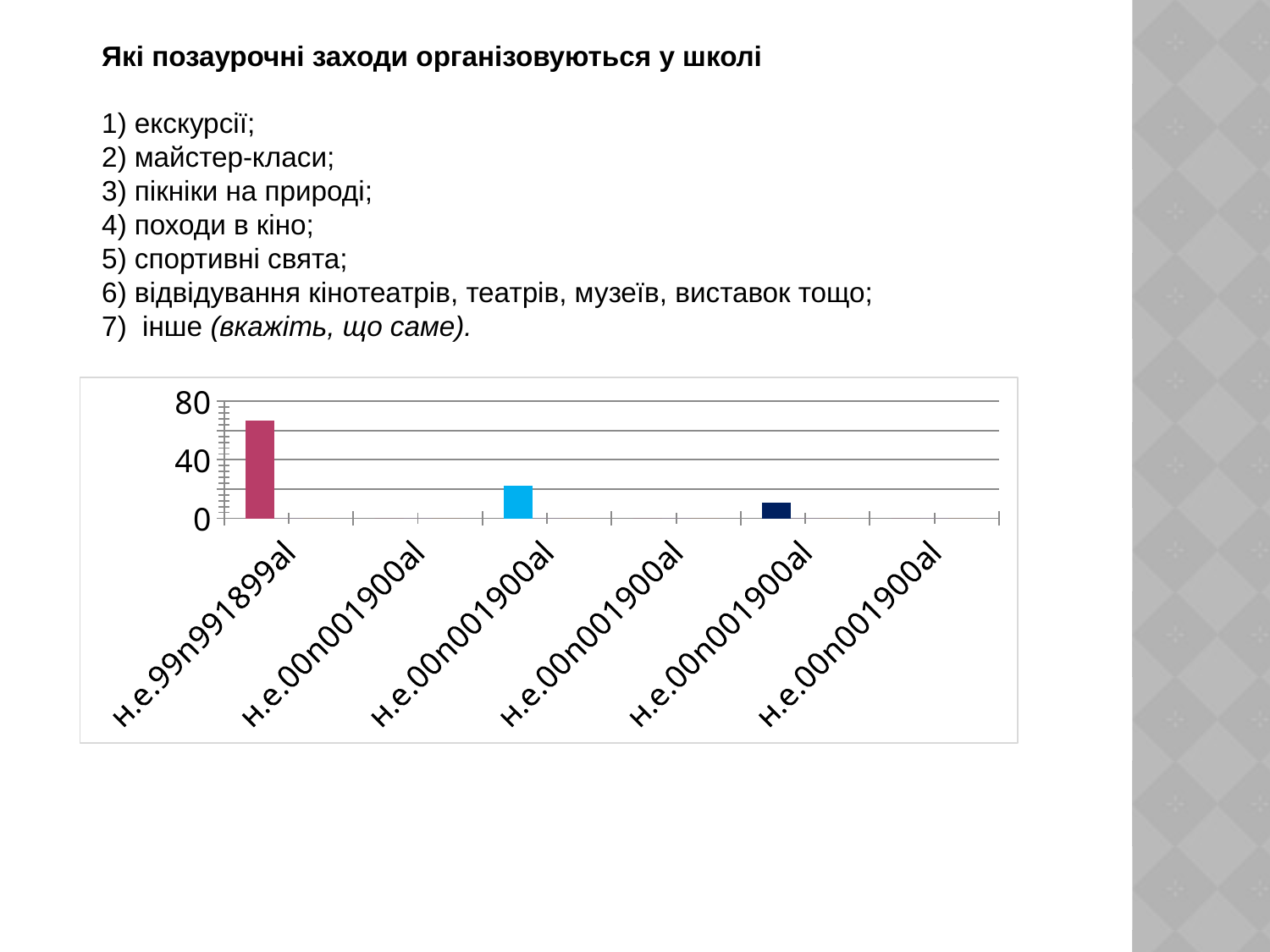
Do the bar values rise or fall from left to right across the chart? fall Which bar in the chart is the shortest? the dark blue bar on the right What colour is the tallest bar in the chart? pink Is the value of the dark blue bar greater or less than 40? less What kind of chart is shown on the slide? bar chart How many bars are plotted in the chart? 3 Is the value of the first (pink) bar greater or less than 40? greater Which bar in the chart is the tallest? the first (pink) bar on the left What is the highest value shown on the vertical axis of the chart? 80 Is the value of the light blue bar greater or less than 40? less Which is larger, the light blue bar or the dark blue bar? the light blue bar Which is larger, the pink bar or the light blue bar? the pink bar